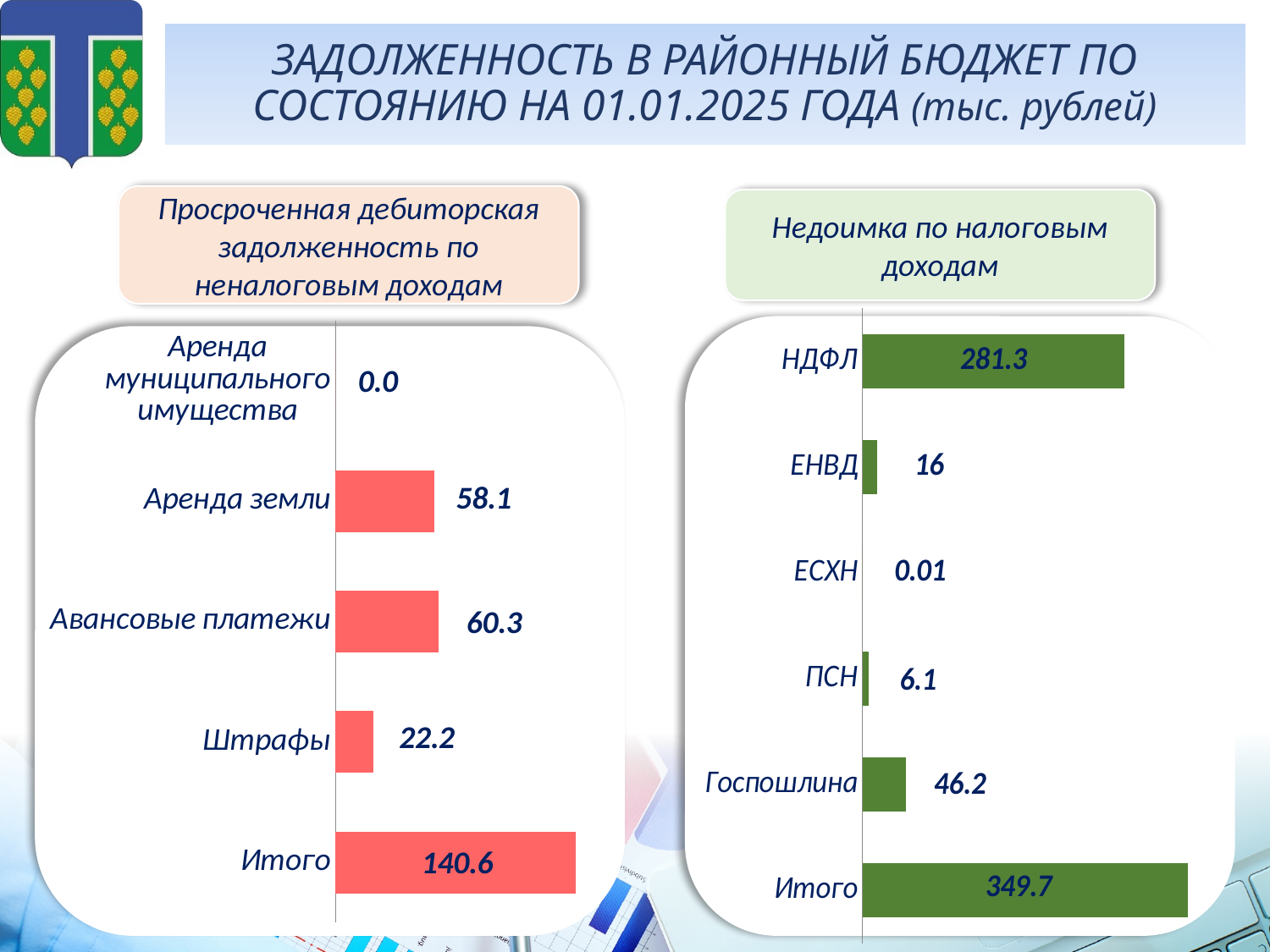
In the chart 'Недоимка по налоговым доходам', what is the value for 'Госпошлина'? 46.2 How many categories, including 'Итого', are shown in the chart 'Недоимка по налоговым доходам'? 6 In the chart 'Просроченная дебиторская задолженность по неналоговым доходам', which category (excluding 'Итого') has the lowest value? Аренда муниципального имущества In the chart 'Недоимка по налоговым доходам', which category has the lowest value? ЕСХН In the chart 'Недоимка по налоговым доходам', which is larger: 'ЕНВД' or 'ПСН'? ЕНВД In the chart 'Недоимка по налоговым доходам', what is the value for 'НДФЛ'? 281.3 In the chart 'Просроченная дебиторская задолженность по неналоговым доходам', what is the difference between 'Авансовые платежи' and 'Штрафы'? 38.1 What kind of chart is used in 'Просроченная дебиторская задолженность по неналоговым доходам'? Bar chart In the chart 'Просроченная дебиторская задолженность по неналоговым доходам', what is the value for 'Итого'? 140.6 In the chart 'Просроченная дебиторская задолженность по неналоговым доходам', what is the value for 'Штрафы'? 22.2 In the chart 'Просроченная дебиторская задолженность по неналоговым доходам', what is the value for 'Аренда земли'? 58.1 In the chart 'Недоимка по налоговым доходам', which category (excluding 'Итого') has the highest value? НДФЛ